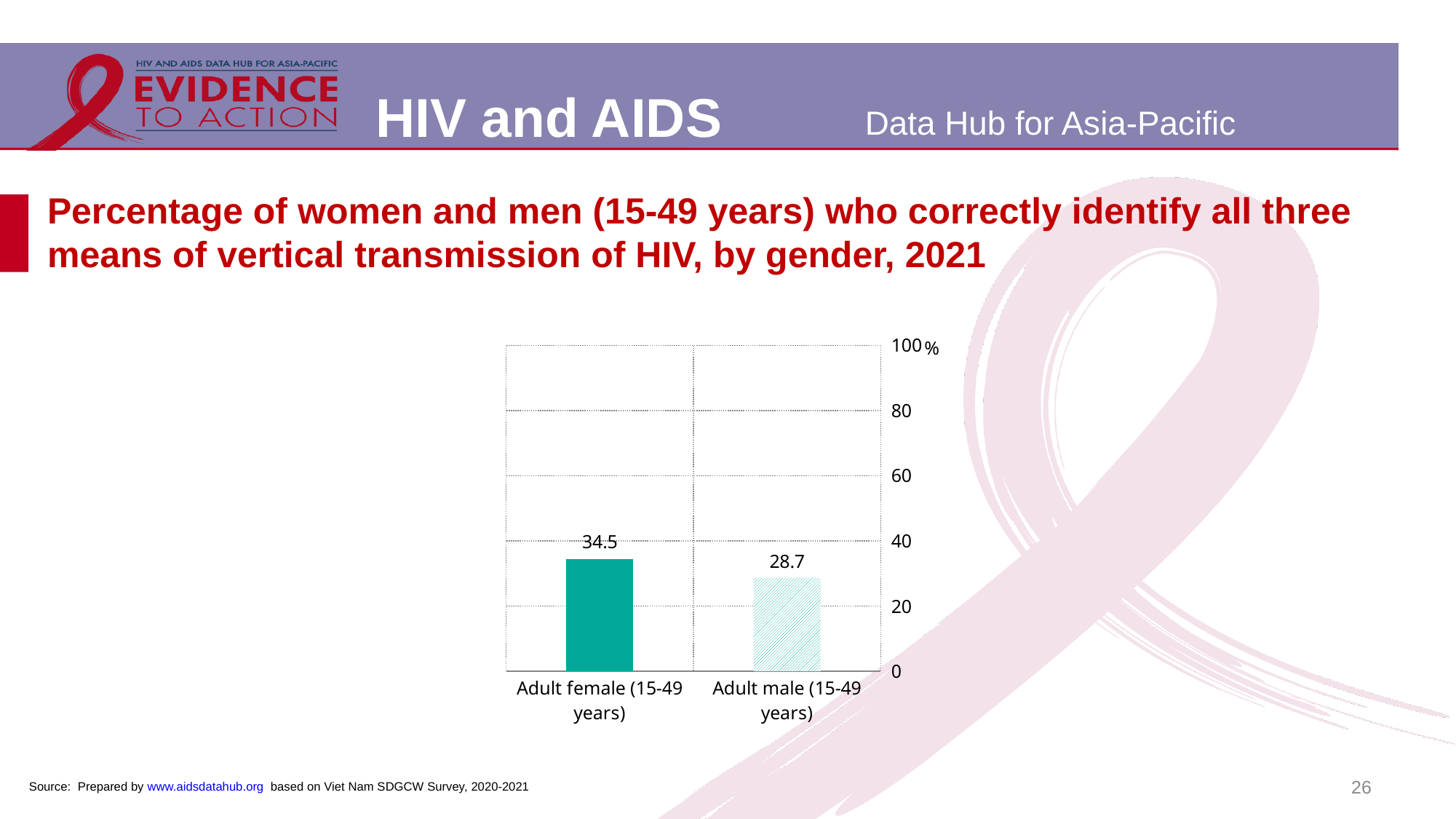
What is the difference between the values for Adult female (15-49 years) and Adult male (15-49 years)? 5.8 What kind of chart is shown on the slide? Bar chart What unit is shown at the top of the vertical axis? % Is the value for Adult female (15-49 years) greater or less than 40? less Which category has the highest value? Adult female (15-49 years) Which is larger, the value for Adult female (15-49 years) or Adult male (15-49 years)? Adult female (15-49 years) What is the value for Adult female (15-49 years)? 34.5 What is the value for Adult male (15-49 years)? 28.7 Is the value for Adult male (15-49 years) greater or less than 20? greater Which category has the lowest value? Adult male (15-49 years) How many categories are shown on the chart? 2 What is the maximum value shown on the vertical axis? 100